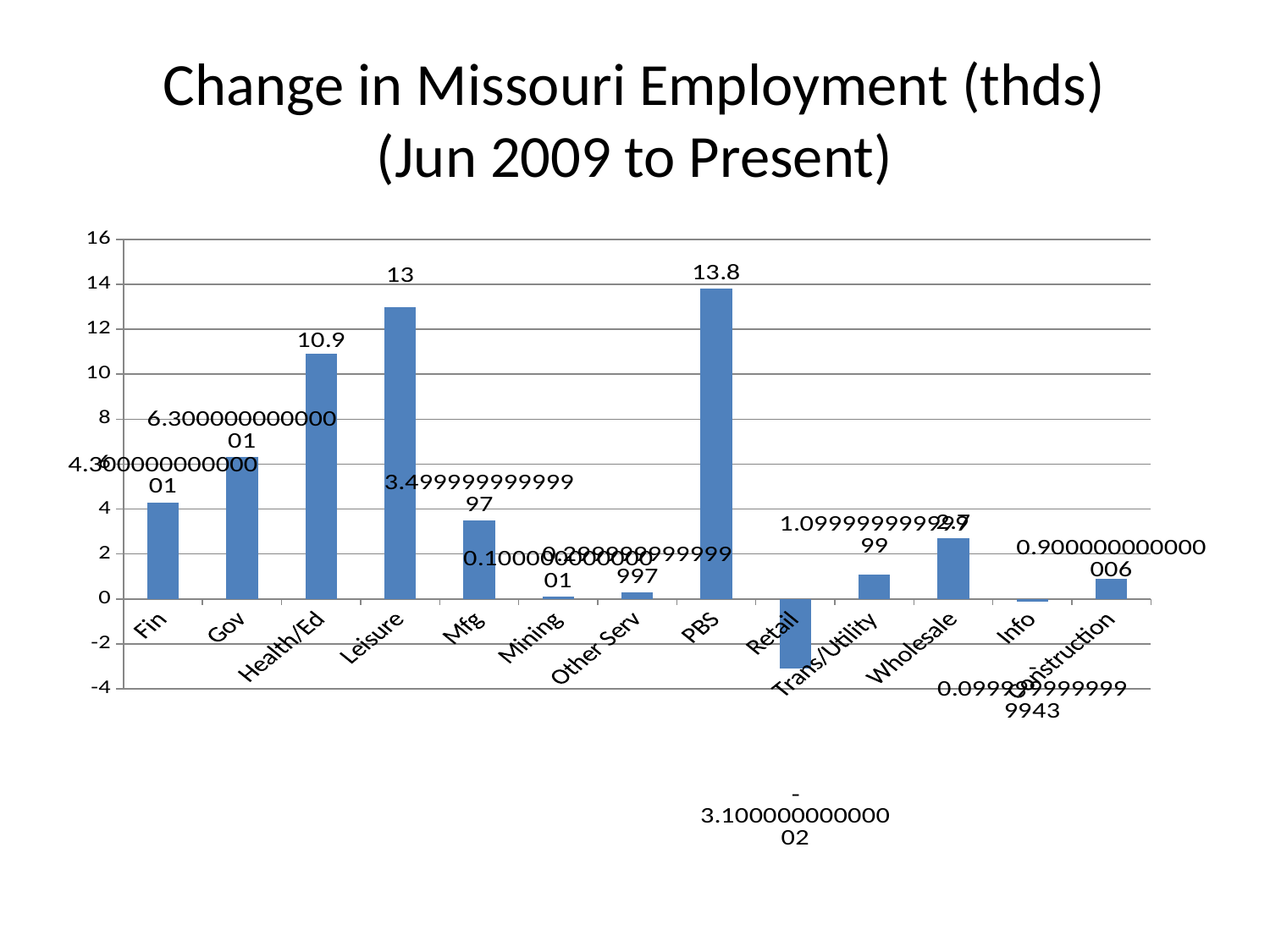
What is the difference between the values for PBS and Leisure? 0.8 Which category has the lowest value? Retail What is the value for Wholesale? 2.7 Is the value for Retail greater or less than 0? less What is the value for PBS? 13.8 Is the value for Gov greater or less than 4? greater What is the value for Health/Ed? 10.9 How many categories are shown on the x axis? 13 What is the value for Leisure? 13 Which category has the highest value? PBS What kind of chart is shown on the slide? bar chart Which is larger, the value for Leisure or the value for Health/Ed? Leisure